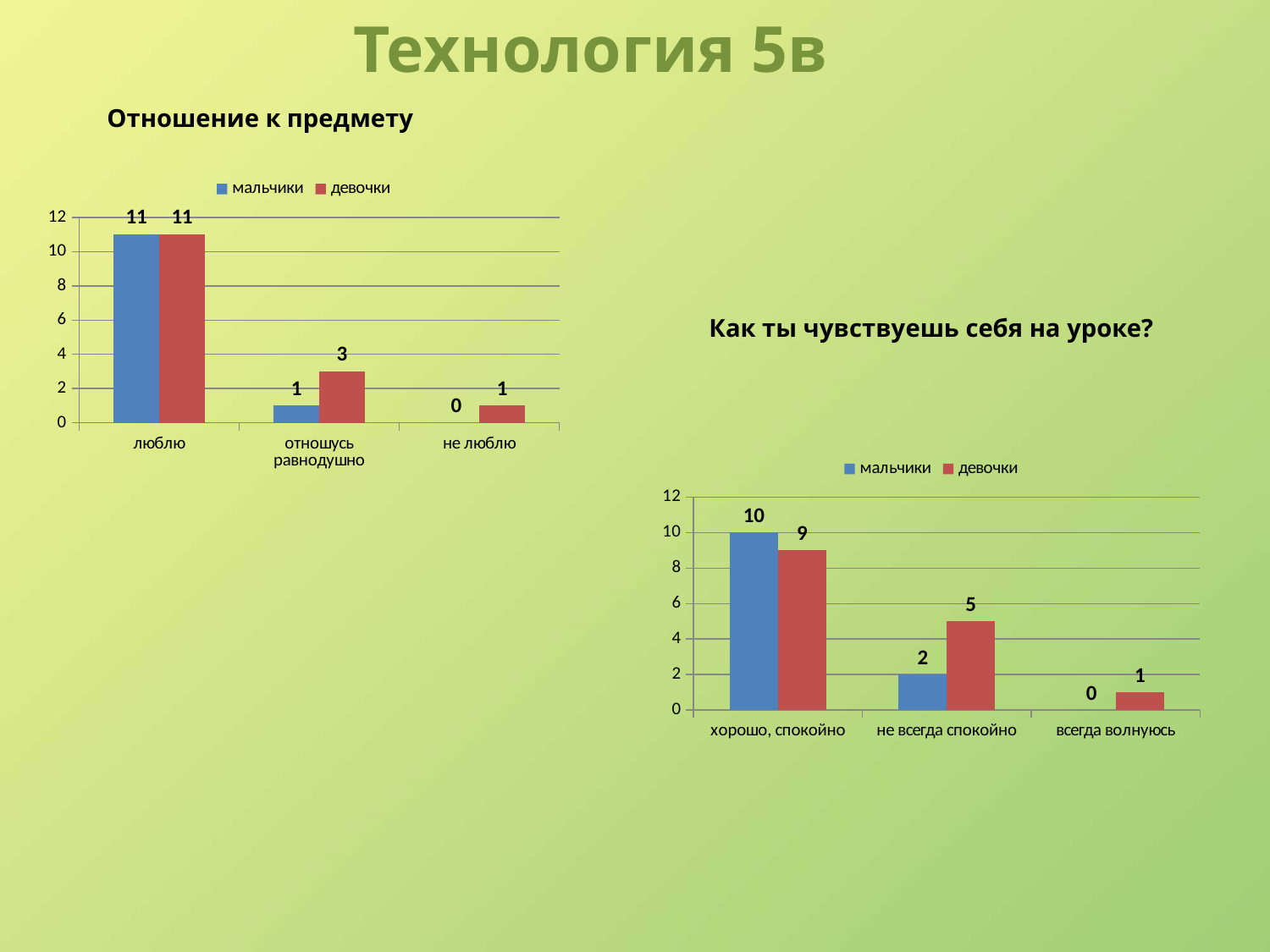
In the chart 'Отношение к предмету', how many categories are shown on the x axis? 3 In the chart 'Отношение к предмету', what is the value for мальчики in the category 'люблю'? 11 In the chart 'Как ты чувствуешь себя на уроке?', what is the difference between мальчики and девочки in the category 'хорошо, спокойно'? 1 In the chart 'Отношение к предмету', what is the value for девочки in the category 'отношусь равнодушно'? 3 In the chart 'Отношение к предмету', what is the value for мальчики in the category 'не люблю'? 0 In the chart 'Как ты чувствуешь себя на уроке?', what is the value for мальчики in the category 'не всегда спокойно'? 2 In the chart 'Как ты чувствуешь себя на уроке?', which is larger in the category 'не всегда спокойно': мальчики or девочки? девочки In the chart 'Как ты чувствуешь себя на уроке?', what is the value for девочки in the category 'хорошо, спокойно'? 9 In the chart 'Как ты чувствуешь себя на уроке?', which category has the highest value for мальчики? хорошо, спокойно How many series does the legend of the chart 'Как ты чувствуешь себя на уроке?' list? 2 In the chart 'Как ты чувствуешь себя на уроке?', which category has the lowest value for девочки? всегда волнуюсь In the chart 'Отношение к предмету', what is the difference between девочки and мальчики in the category 'отношусь равнодушно'? 2